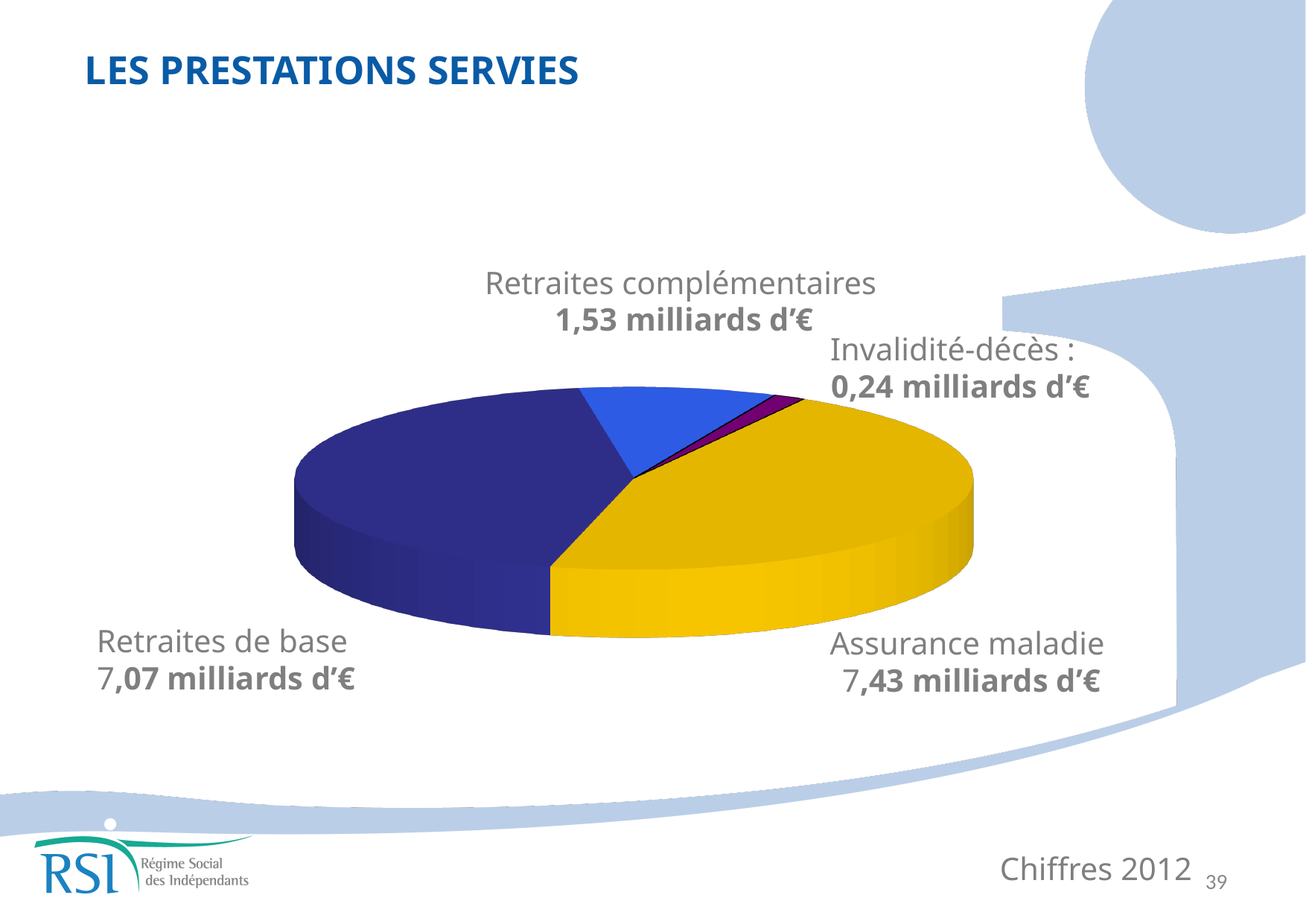
What is the value for Retraites de base? 7,07 milliards d'€ Which category has the largest value? Assurance maladie What is the value for Retraites complémentaires? 1,53 milliards d'€ What is the value for Assurance maladie? 7,43 milliards d'€ What is the difference between Assurance maladie and Retraites de base? 0,36 milliards d'€ Which category has the smallest value? Invalidité-décès Which is larger, Retraites de base or Retraites complémentaires? Retraites de base What is the value for Invalidité-décès? 0,24 milliards d'€ What colour is the Assurance maladie slice? Yellow What kind of chart is shown on the slide? Pie chart What is the difference between Retraites complémentaires and Invalidité-décès? 1,29 milliards d'€ How many categories are shown in the pie chart? 4